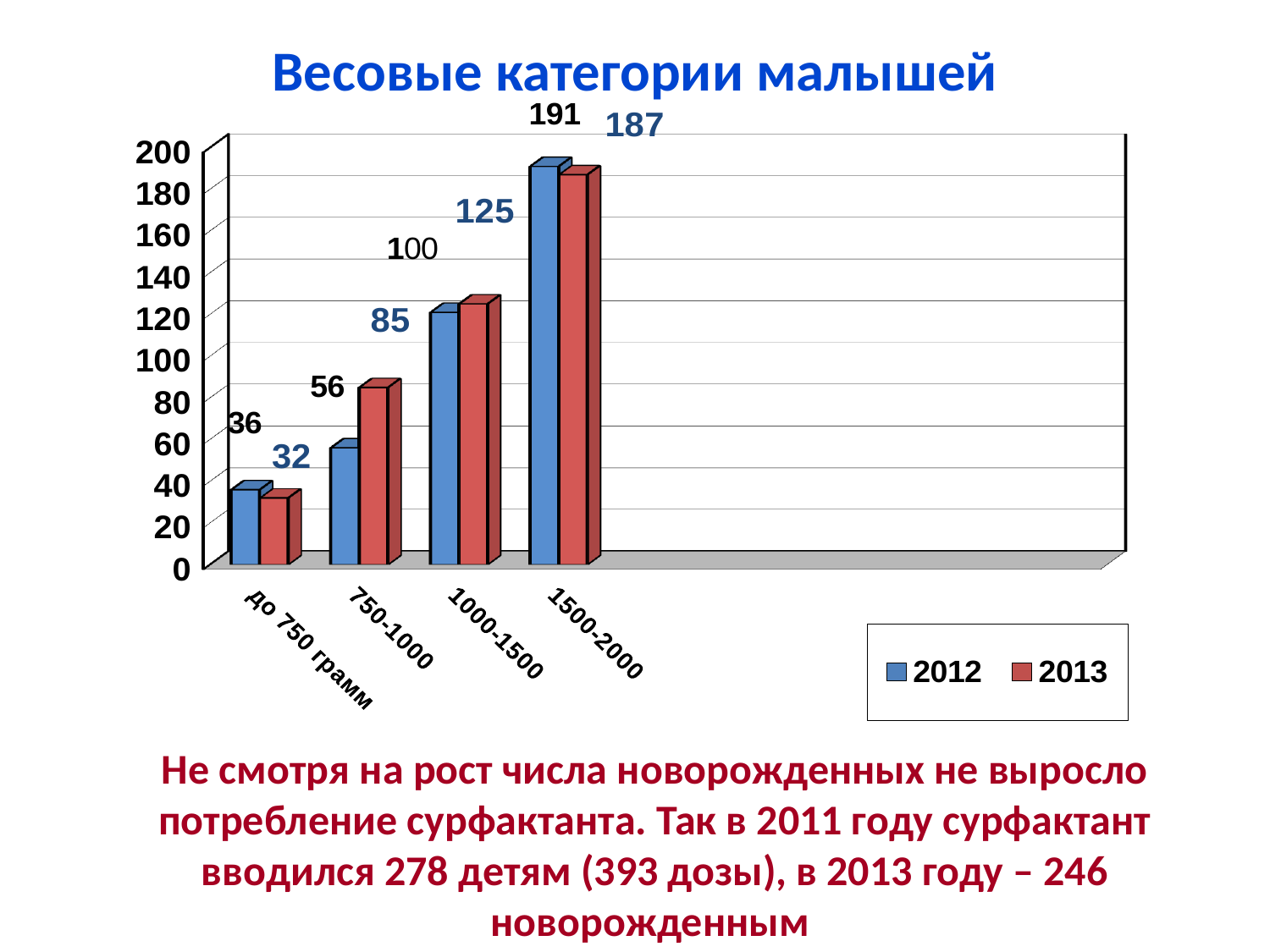
In the '1000-1500' category, which year has the larger value, 2012 or 2013? 2013 Which category has the lowest value for 2012? до 750 грамм What is the value for 2012 in the '1500-2000' category? 191 What is the value for 2013 in the '1000-1500' category? 125 How many weight categories are shown on the x axis? 4 What is the value for 2013 in the '750-1000' category? 85 What kind of chart is shown on the slide? bar chart What is the value for 2012 in the 'до 750 грамм' category? 36 What is the title of the chart? Весовые категории малышей Which category has the highest value for 2013? 1500-2000 What is the difference between the 2013 and 2012 values in the '750-1000' category? 29 How many series does the legend list? 2